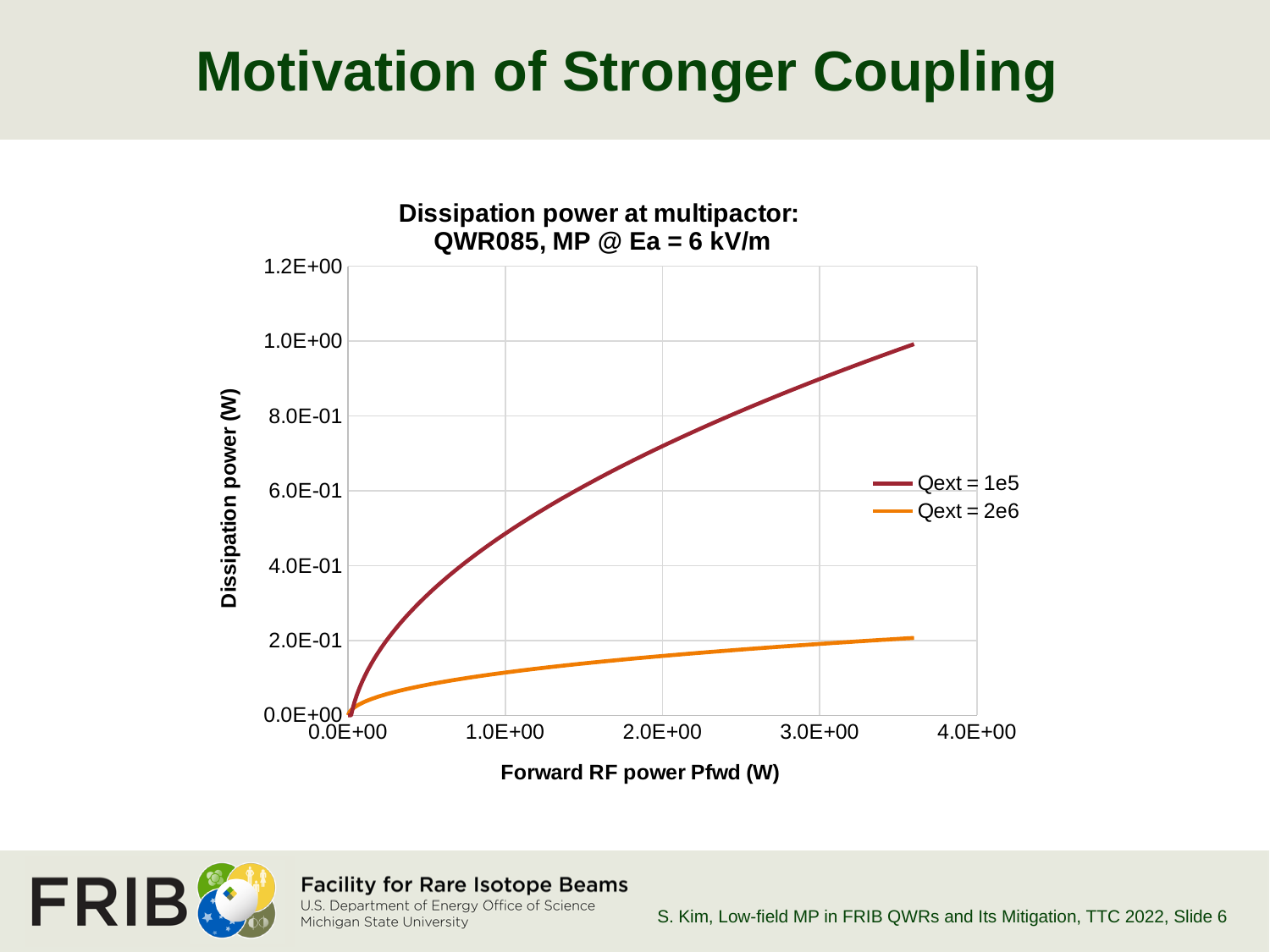
Is the dissipation power for Qext = 2e6 at a forward RF power of 2.0E+00 W greater or less than 2.0E-01 W? less At a forward RF power of 2.0E+00 W, which series has the larger dissipation power? Qext = 1e5 How many series does the legend list? 2 Is the maximum dissipation power reached by the Qext = 2e6 series greater or less than 4.0E-01 W? less Does the dissipation power for Qext = 1e5 rise or fall as forward RF power increases? rise Is the dissipation power for Qext = 1e5 at a forward RF power of 3.0E+00 W greater or less than 8.0E-01 W? greater Does the dissipation power for Qext = 2e6 rise or fall as forward RF power increases? rise What kind of chart is shown on the slide? line chart Which series reaches the higher dissipation power, Qext = 1e5 or Qext = 2e6? Qext = 1e5 What is the title of the chart? Dissipation power at multipactor: QWR085, MP @ Ea = 6 kV/m What is the label of the x axis? Forward RF power Pfwd (W)